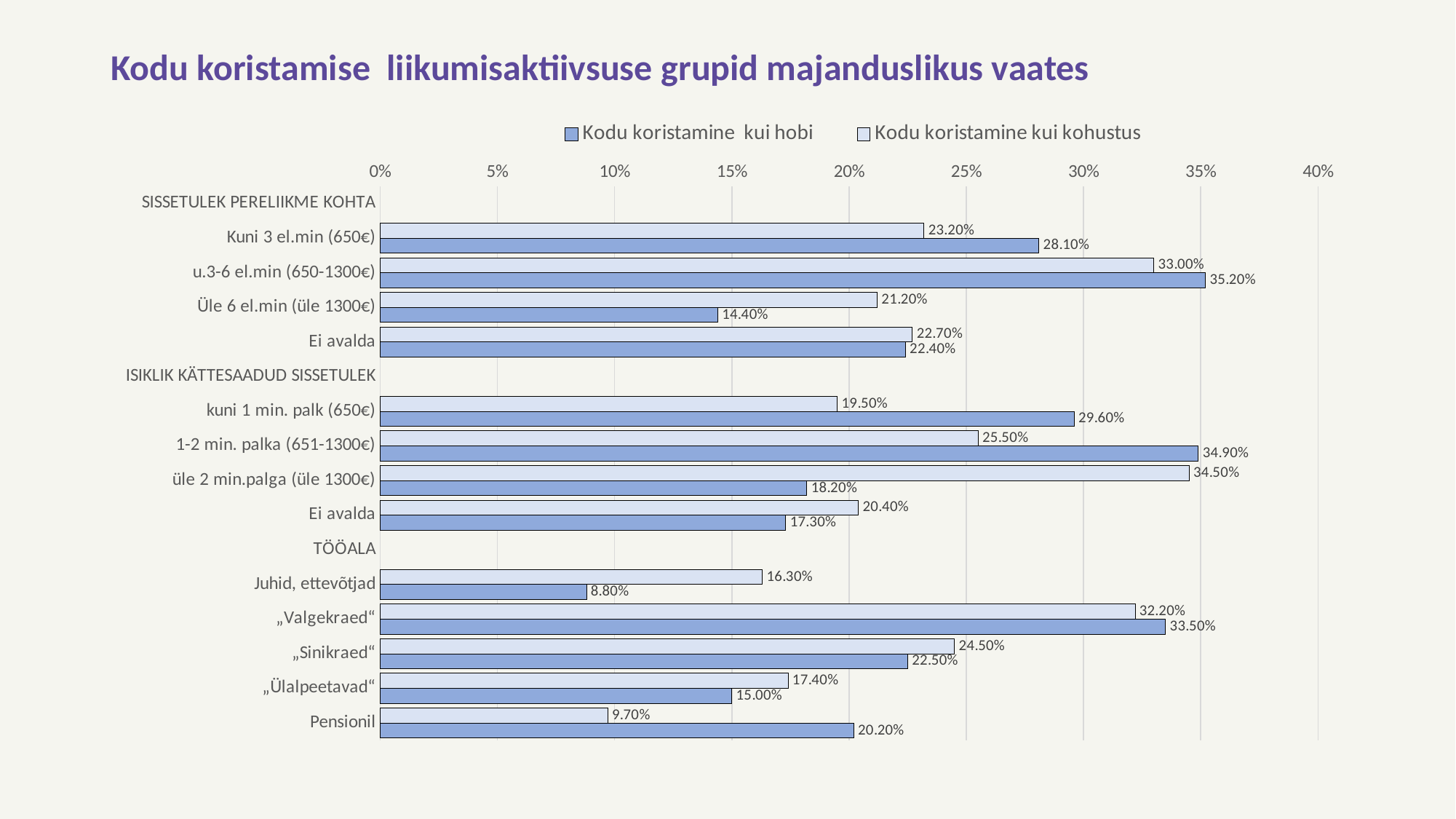
How many series does the legend list? 2 What is the difference between the "Kodu koristamine kui hobi" and "Kodu koristamine kui kohustus" values for "kuni 1 min. palk (650€)"? 10.10% What is the title of the chart? Kodu koristamise liikumisaktiivsuse grupid majanduslikus vaates Which category has the lowest value for "Kodu koristamine kui hobi"? Juhid, ettevõtjad What is the value of "Kodu koristamine kui hobi" for "Juhid, ettevõtjad"? 8.80% Is the "Kodu koristamine kui hobi" value for "„Valgekraed“" greater or less than 30%? greater What is the value of "Kodu koristamine kui hobi" for "u.3-6 el.min (650-1300€)"? 35.20% What is the value of "Kodu koristamine kui kohustus" for "Pensionil"? 9.70% For "Üle 6 el.min (üle 1300€)", which series has the larger value: "Kodu koristamine kui hobi" or "Kodu koristamine kui kohustus"? Kodu koristamine kui kohustus What type of chart is shown on the slide? bar chart Which category has the highest value for "Kodu koristamine kui kohustus"? üle 2 min.palga (üle 1300€) What is the difference between the "Kodu koristamine kui kohustus" and "Kodu koristamine kui hobi" values for "„Sinikraed“"? 2.00%